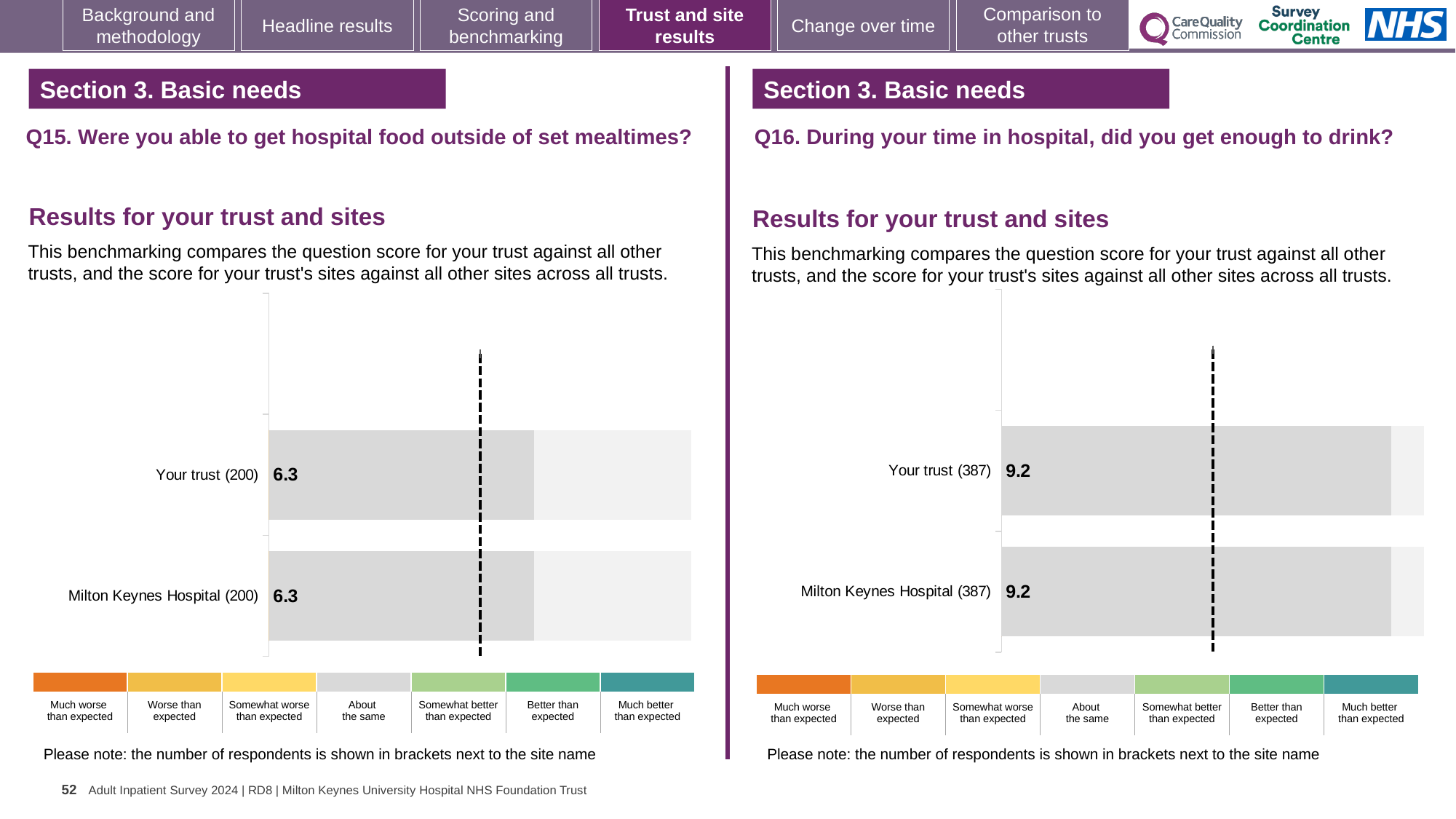
On the Q15 chart (left), what is the score for Your trust? 6.3 What kind of chart is shown on the Q16 chart (right)? Bar chart On the Q15 chart (left), what is the score for Milton Keynes Hospital? 6.3 What is the difference between the Your trust score on the Q16 chart (right) and the Your trust score on the Q15 chart (left)? 2.9 On the Q16 chart (right), how many respondents are shown in brackets for Milton Keynes Hospital? 387 On the Q15 chart (left), how many bars are plotted? 2 On the Q16 chart (right), what is the score for Milton Keynes Hospital? 9.2 On the Q16 chart (right), how many bars are plotted? 2 Is the score for Your trust on the Q16 chart (right) larger or smaller than the score for Your trust on the Q15 chart (left)? Larger On the Q16 chart (right), what is the score for Your trust? 9.2 On the Q15 chart (left), how many respondents are shown in brackets for Your trust? 200 On the Q15 chart (left), what is the difference between the score for Your trust and the score for Milton Keynes Hospital? 0